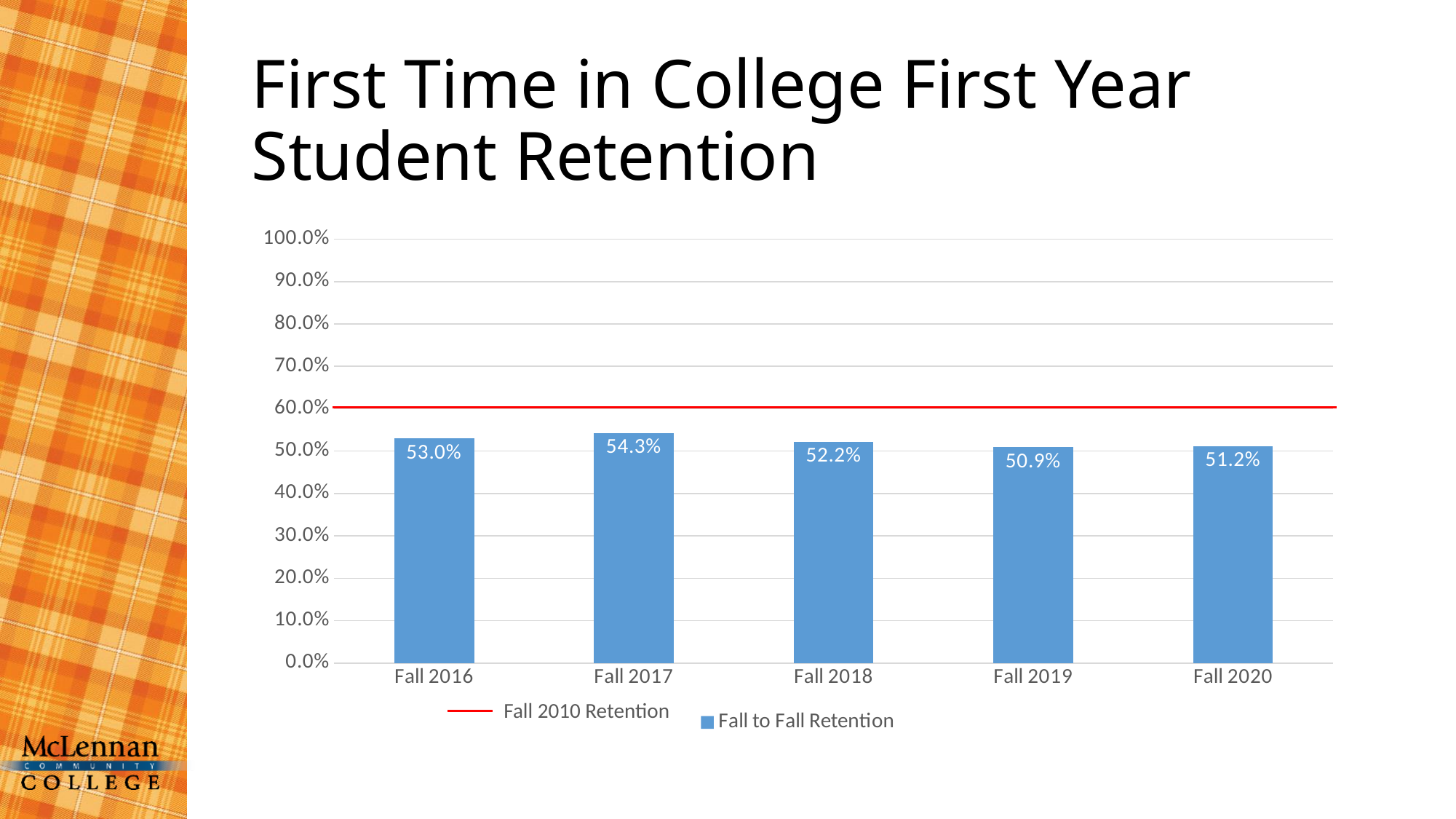
What is the Fall to Fall Retention value for Fall 2020? 51.2% Which term has the lowest Fall to Fall Retention? Fall 2019 How many terms are shown on the x axis? 5 How many series does the legend list? 2 What does the red horizontal line represent according to the legend? Fall 2010 Retention What is the Fall to Fall Retention value for Fall 2019? 50.9% Is the Fall to Fall Retention for Fall 2018 greater or less than 60.0%? less What is the difference between the Fall 2017 and Fall 2019 retention values? 3.4% Which is larger, the retention for Fall 2016 or Fall 2018? Fall 2016 Which term has the highest Fall to Fall Retention? Fall 2017 What kind of chart is shown on the slide? bar chart What is the Fall to Fall Retention value for Fall 2017? 54.3%